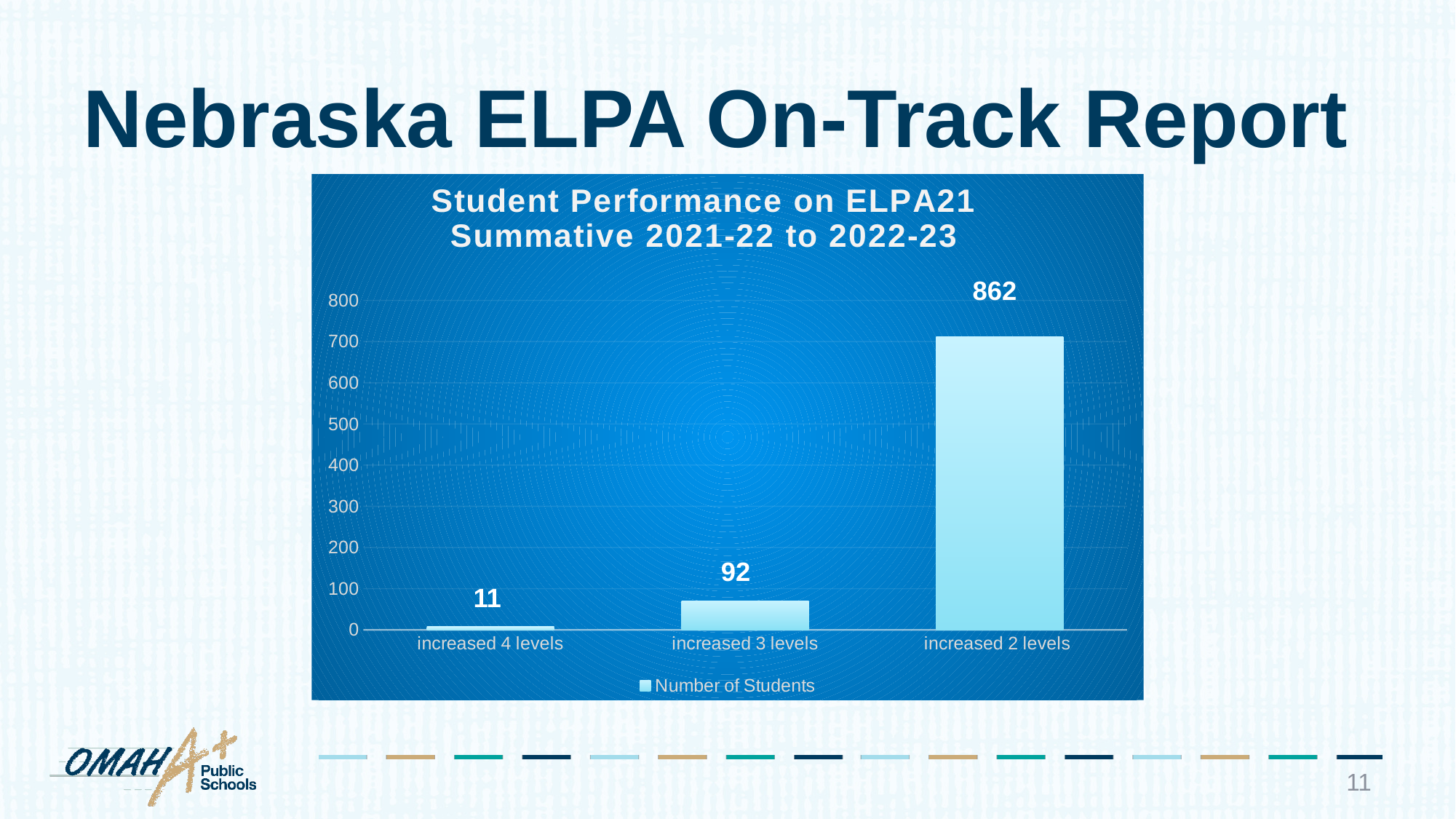
What is the number of students who increased 2 levels? 862 Which category has the lowest number of students? increased 4 levels What kind of chart is shown on the slide? bar chart What is the difference between the number of students who increased 3 levels and those who increased 4 levels? 81 Which is larger: the number of students who increased 3 levels or the number who increased 4 levels? increased 3 levels What is the title of the chart? Student Performance on ELPA21 Summative 2021-22 to 2022-23 Which category has the highest number of students? increased 2 levels How many categories are shown on the x axis? 3 What is the number of students who increased 3 levels? 92 Is the value for increased 3 levels greater or less than 100? less What is the number of students who increased 4 levels? 11 What is the difference between the number of students who increased 2 levels and those who increased 3 levels? 770